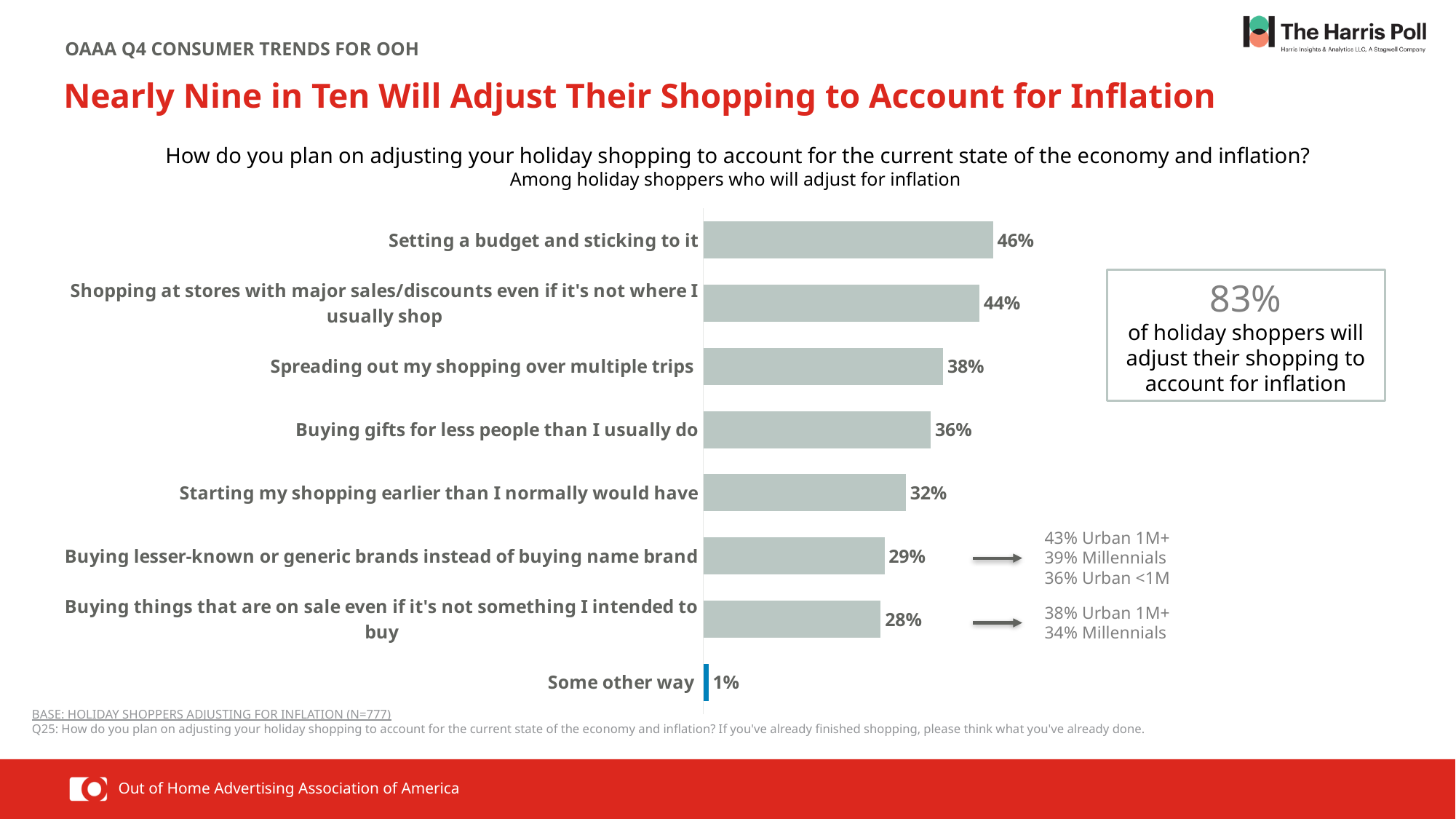
What is the difference between 'Shopping at stores with major sales/discounts even if it's not where I usually shop' and 'Buying lesser-known or generic brands instead of buying name brand'? 15 percentage points What percentage of holiday shoppers will adjust their shopping to account for inflation, according to the callout box? 83% Which is larger: 'Buying gifts for less people than I usually do' or 'Buying things that are on sale even if it's not something I intended to buy'? Buying gifts for less people than I usually do What is the value for 'Some other way'? 1% What is the difference between 'Setting a budget and sticking to it' and 'Starting my shopping earlier than I normally would have'? 14 percentage points What is the value for 'Buying lesser-known or generic brands instead of buying name brand'? 29% Which category has the highest value in the chart? Setting a budget and sticking to it What percentage of holiday shoppers who will adjust for inflation plan on setting a budget and sticking to it? 46% How many categories are shown in the bar chart? 8 What is the value for 'Spreading out my shopping over multiple trips'? 38% What type of chart is shown on the slide? Bar chart Which category has the lowest value in the chart? Some other way